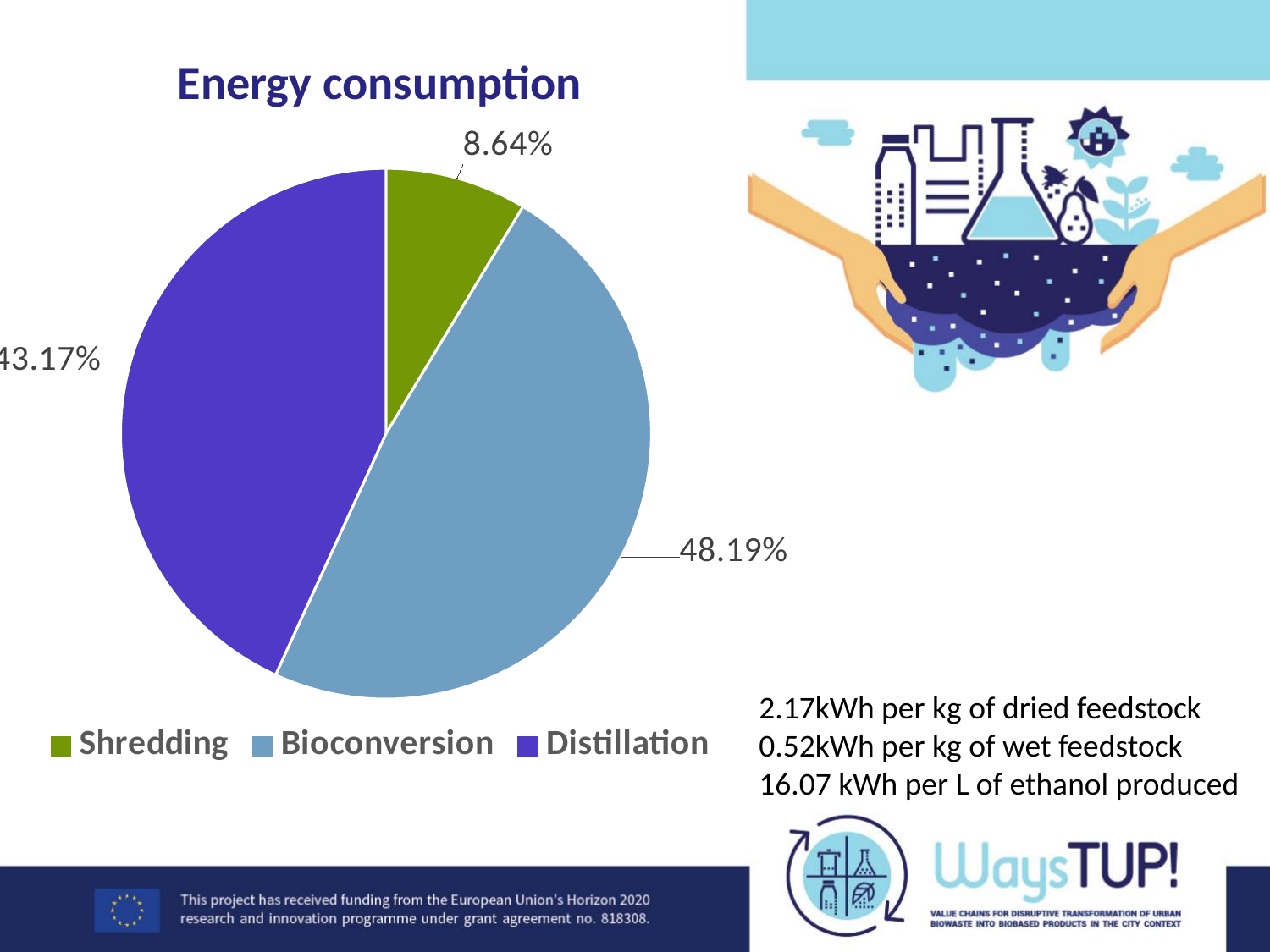
What share of energy consumption is attributed to Shredding? 8.64% Which category accounts for the largest share of energy consumption? Bioconversion What share of energy consumption is attributed to Distillation? 43.17% How many entries does the legend list? 3 Which has a larger share of energy consumption, Distillation or Shredding? Distillation Which colour represents Distillation in the pie chart? purple What share of energy consumption is attributed to Bioconversion? 48.19% What is the title of the chart? Energy consumption What kind of chart is shown on the slide? pie chart How many slices does the pie chart have? 3 Which category accounts for the smallest share of energy consumption? Shredding What is the difference in percentage points between the Bioconversion and Shredding shares? 39.55